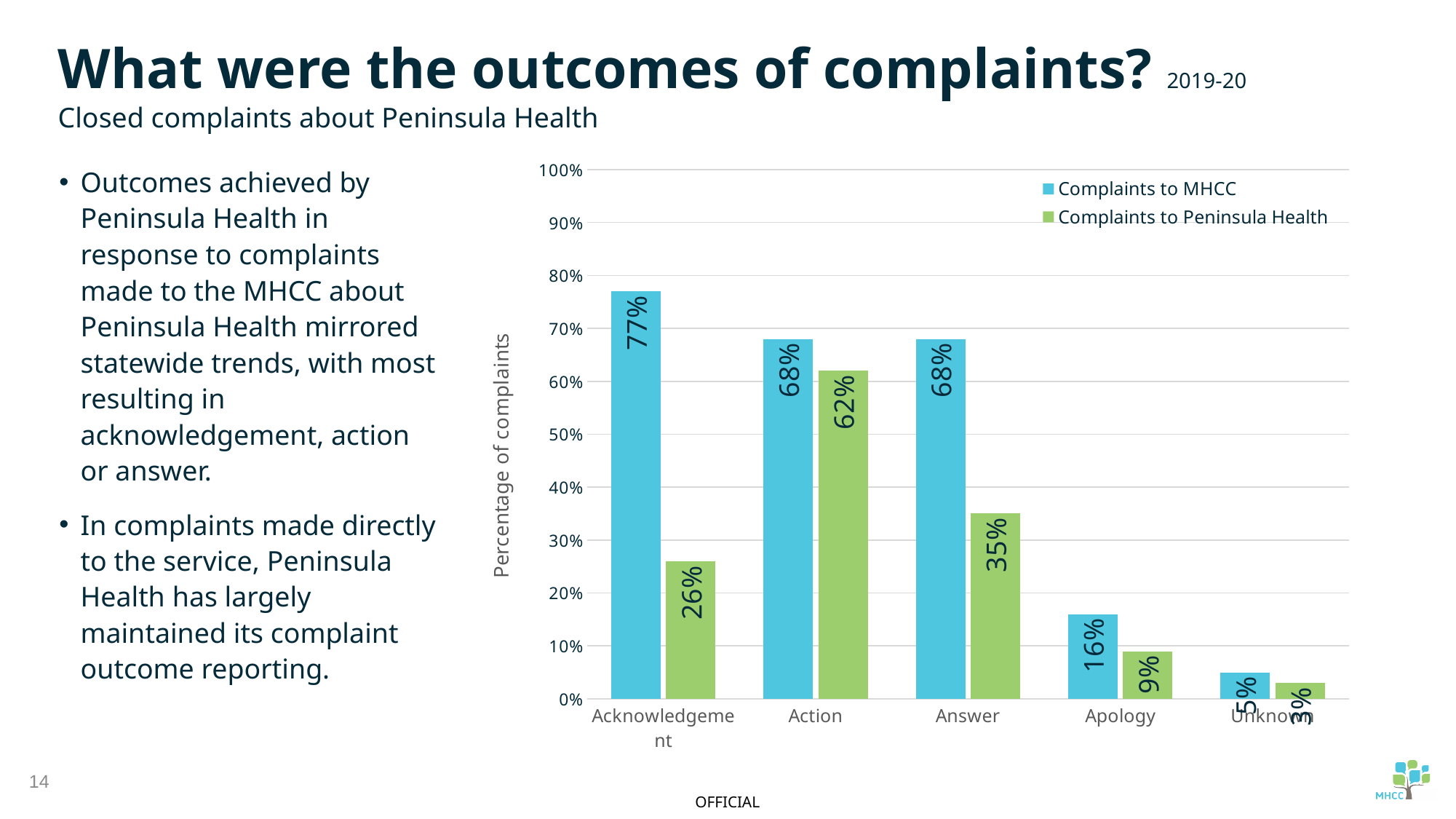
What is the difference between Complaints to MHCC and Complaints to Peninsula Health for Acknowledgement? 51% Which outcome has the highest value for Complaints to MHCC? Acknowledgement What percentage of complaints to MHCC resulted in Acknowledgement? 77% Which outcome has the lowest value for Complaints to Peninsula Health? Unknown How many series does the legend list? 2 What kind of chart is shown on the slide? Bar chart What percentage of complaints to MHCC resulted in Apology? 16% What percentage of complaints to Peninsula Health resulted in Action? 62% How many outcome categories are shown on the x axis? 5 For Apology, which series has the larger value: Complaints to MHCC or Complaints to Peninsula Health? Complaints to MHCC What percentage of complaints to Peninsula Health resulted in Answer? 35% What is the label of the vertical axis? Percentage of complaints